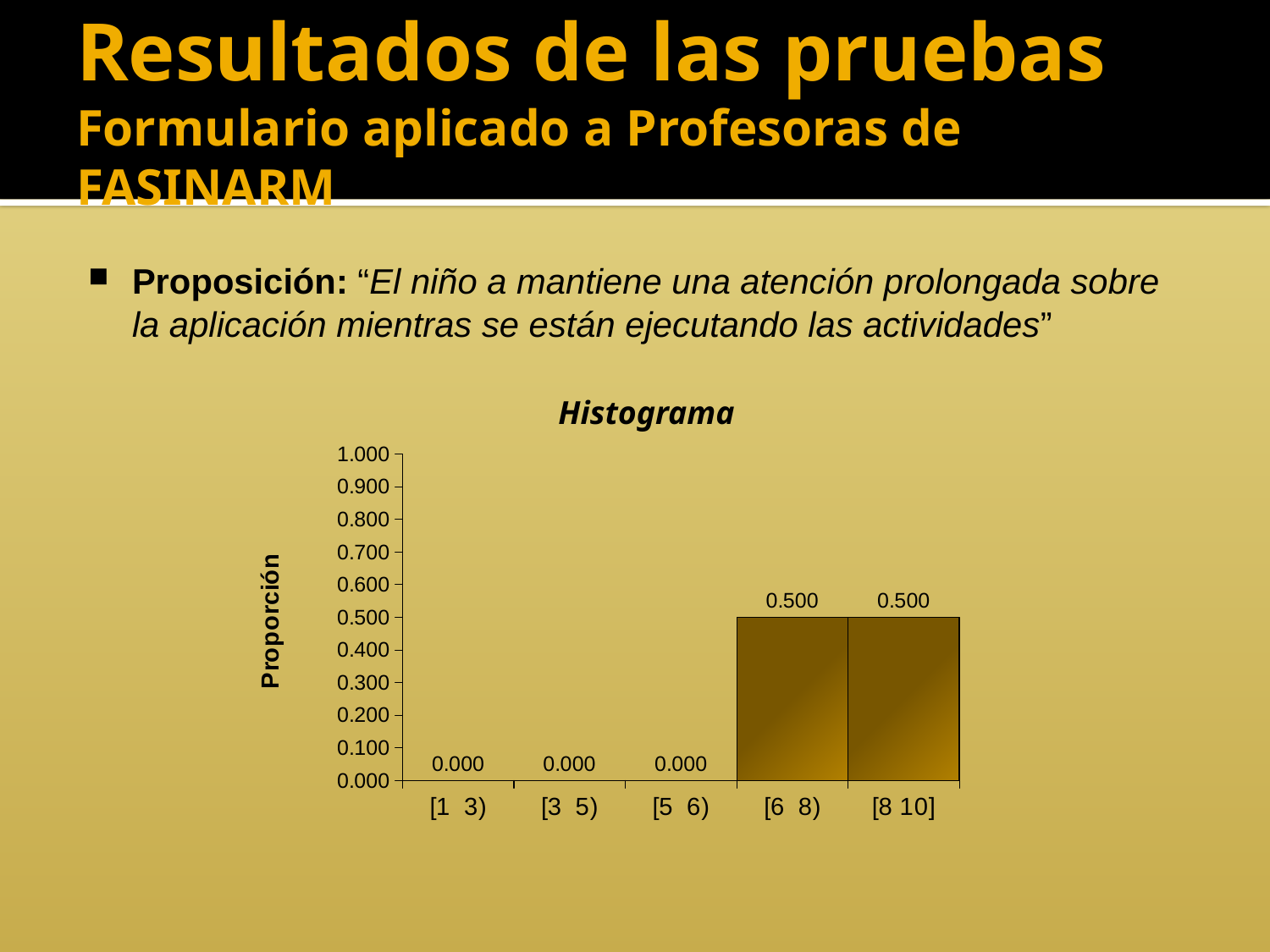
What is the value for the [1 3) bin in the Histograma chart? 0.000 Is the value for the [6 8) bin greater or less than 0.400? greater What is the label of the vertical axis of the chart? Proporción Which is larger, the value for the [8 10] bin or the value for the [5 6) bin? [8 10] What is the value for the [6 8) bin in the Histograma chart? 0.500 What is the difference between the values for the [6 8) bin and the [3 5) bin? 0.500 How many bins are shown on the x axis of the Histograma chart? 5 What is the value for the [8 10] bin in the Histograma chart? 0.500 What is the title of the chart on the slide? Histograma What is the value for the [5 6) bin in the Histograma chart? 0.000 What is the sum of the values for the [6 8) and [8 10] bins? 1.000 What kind of chart is shown on the slide? bar chart